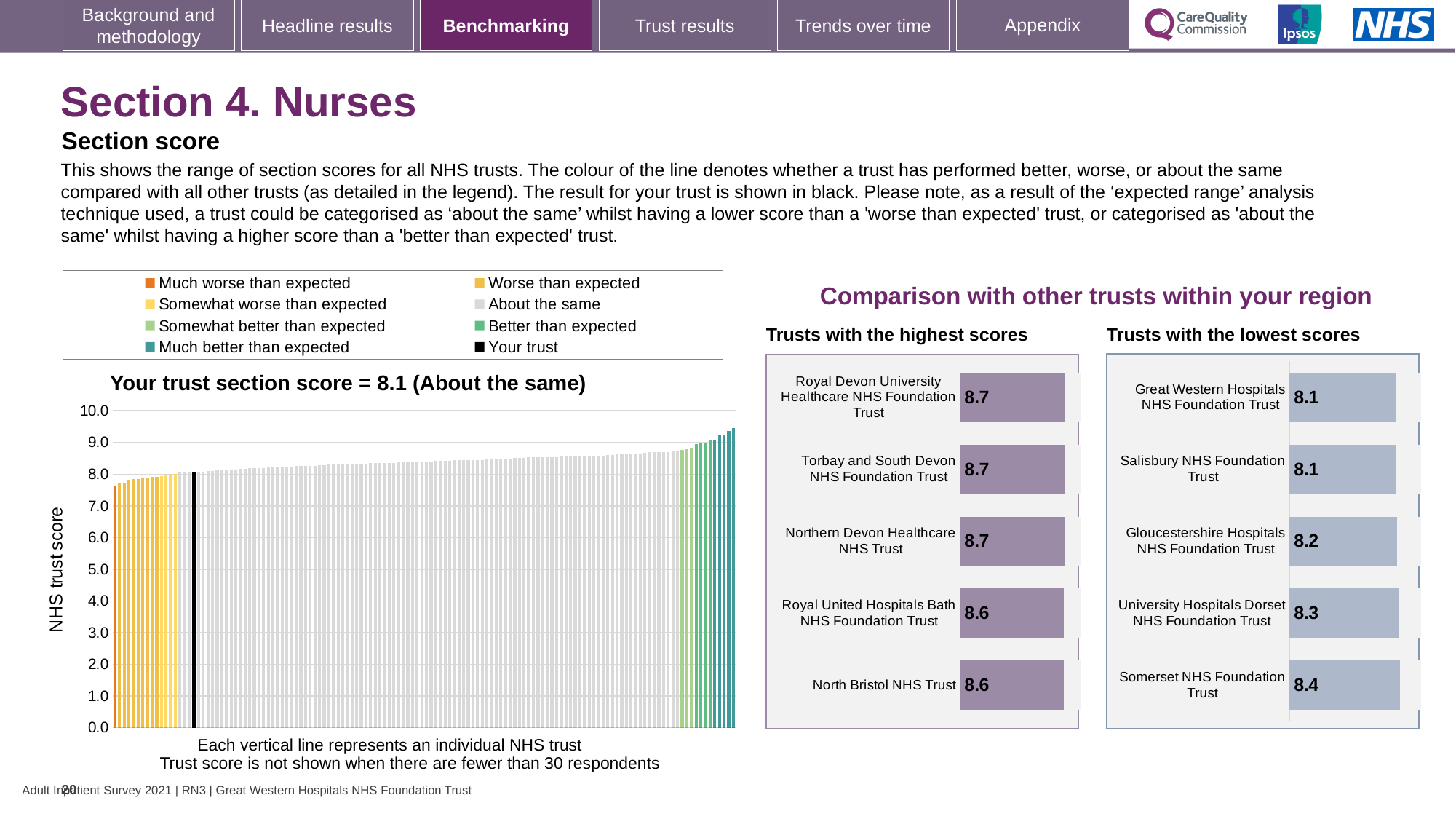
On the 'Trusts with the highest scores' chart, what is the score for Royal United Hospitals Bath NHS Foundation Trust? 8.6 On the 'Your trust section score' chart, what is the label of the y axis? NHS trust score On the 'Trusts with the lowest scores' chart, which trust has the highest score? Somerset NHS Foundation Trust On the 'Your trust section score' chart, how many entries does the legend list? 8 On the 'Your trust section score' chart, what is the section score for your trust? 8.1 On the 'Trusts with the highest scores' chart, what is the difference between the scores of Royal Devon University Healthcare NHS Foundation Trust and North Bristol NHS Trust? 0.1 On the 'Trusts with the highest scores' chart, how many trusts are shown? 5 What kind of chart is the 'Your trust section score' chart? Bar chart On the 'Your trust section score' chart, do the bars rise or fall from left to right? Rise On the 'Your trust section score' chart, is the value of the leftmost (orange) bar greater or less than 8.0? less On the 'Your trust section score' chart, is the value of the rightmost bar greater or less than 9.0? greater On the 'Trusts with the lowest scores' chart, what is the score for Gloucestershire Hospitals NHS Foundation Trust? 8.2